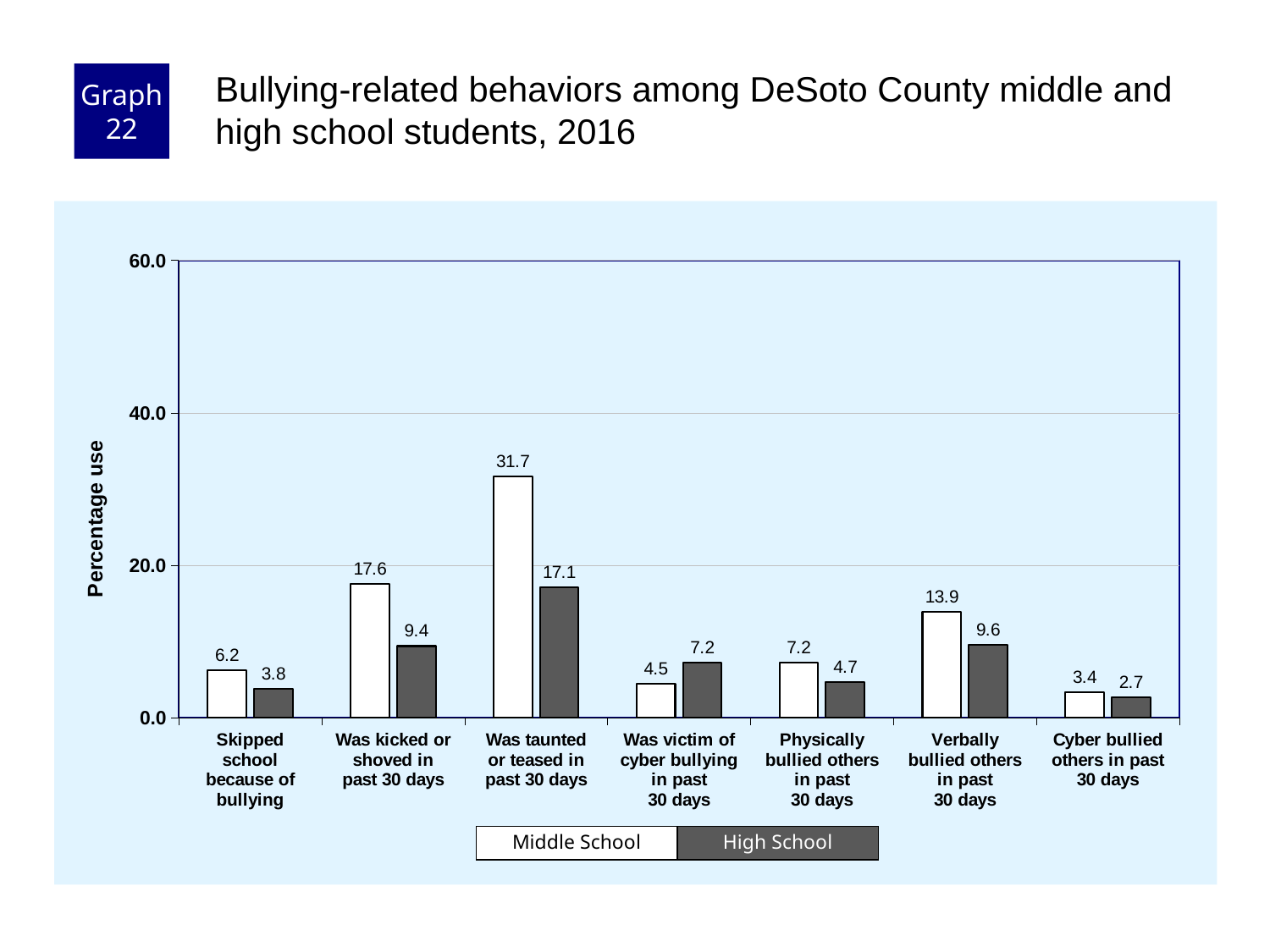
How many series does the legend list? 2 For "Was victim of cyber bullying in past 30 days", which is larger, the Middle School or High School value? High School What is the label of the y axis? Percentage use Which category has the highest Middle School value? Was taunted or teased in past 30 days Is the Middle School value for "Was taunted or teased in past 30 days" greater or less than 20.0? greater What is the difference between the Middle School and High School values for "Verbally bullied others in past 30 days"? 4.3 What is the High School value for "Was kicked or shoved in past 30 days"? 9.4 What is the Middle School value for "Was taunted or teased in past 30 days"? 31.7 How many categories are shown on the x axis? 7 What kind of chart is shown on the slide? Bar chart Which category has the lowest High School value? Cyber bullied others in past 30 days What is the High School value for "Was victim of cyber bullying in past 30 days"? 7.2